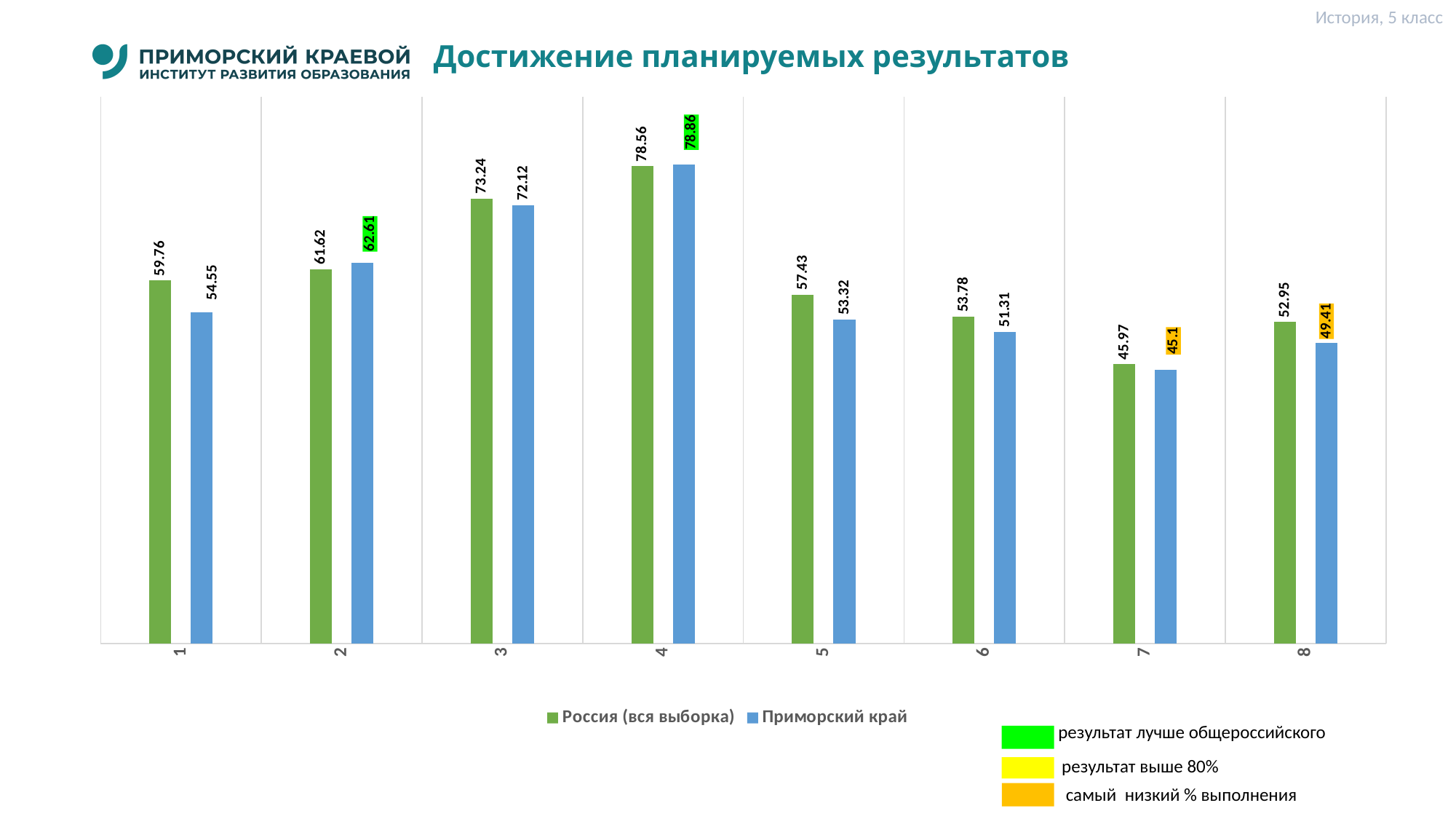
What is the difference between Россия (вся выборка) and Приморский край for category 5? 4.11 Which category has the highest value for Приморский край? 4 What kind of chart is shown on the slide? bar chart What is the value for Приморский край for category 8? 49.41 Which category has the lowest value for Россия (вся выборка)? 7 What colour are the bars for Приморский край? blue What is the value for Россия (вся выборка) for category 3? 73.24 What is the value for Приморский край for category 2? 62.61 For category 6, which is larger: Россия (вся выборка) or Приморский край? Россия (вся выборка) How many series does the legend list? 2 How many categories are shown on the x axis? 8 What is the difference between Россия (вся выборка) and Приморский край for category 1? 5.21